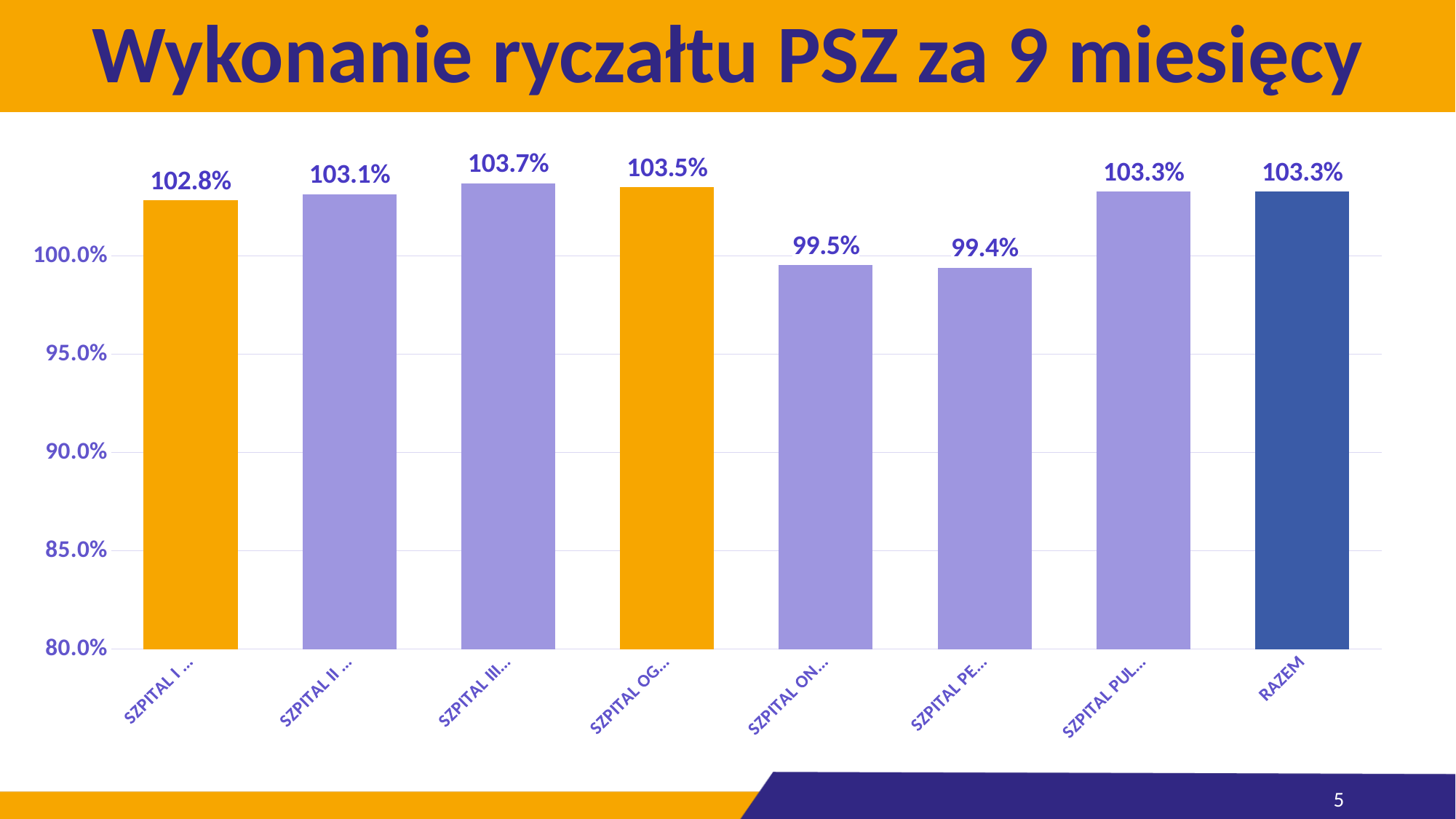
What is the value of the fifth bar from the left (SZPITAL ON...)? 99.5% Is the value for the sixth bar (SZPITAL PE...) greater or less than 100.0%? less Which bar has the lowest value, and what is it? The sixth bar from the left (SZPITAL PE...), 99.4% What is the difference between the highest value (103.7%) and the lowest value (99.4%)? 4.3 percentage points What is the value of the leftmost bar (SZPITAL I ...)? 102.8% How many bars have values below 100.0%? 2 What type of chart is shown on the slide? Bar chart What is the value shown for RAZEM? 103.3% What is the title of the slide? Wykonanie ryczałtu PSZ za 9 miesięcy How many bars are shown in the chart? 8 Which is larger: the value of the first bar (SZPITAL I ...) or the second bar (SZPITAL II ...)? The second bar (103.1%) Which bar has the highest value, and what is it? The third bar from the left (SZPITAL III...), 103.7%